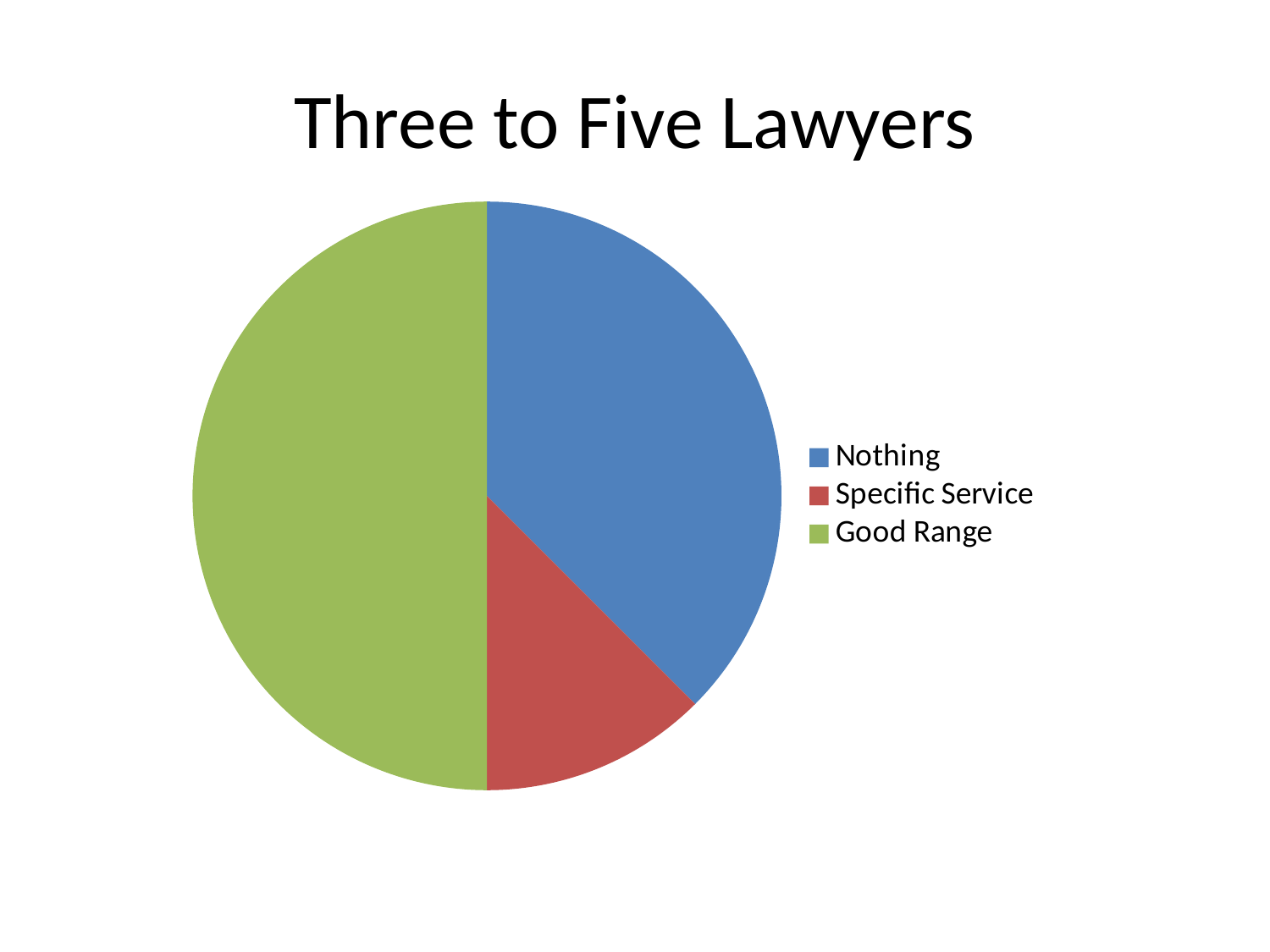
Which category has the largest slice of the pie? Good Range Which category has the smallest slice of the pie? Specific Service Which slice is larger, Nothing or Specific Service? Nothing What colour is the Good Range slice? green Which slice is larger, Good Range or Nothing? Good Range How many entries does the legend list? 3 Which slice is smaller, Good Range or Specific Service? Specific Service What is the title of the chart? Three to Five Lawyers How many slices does the pie chart have? 3 What kind of chart is shown on the slide? pie chart